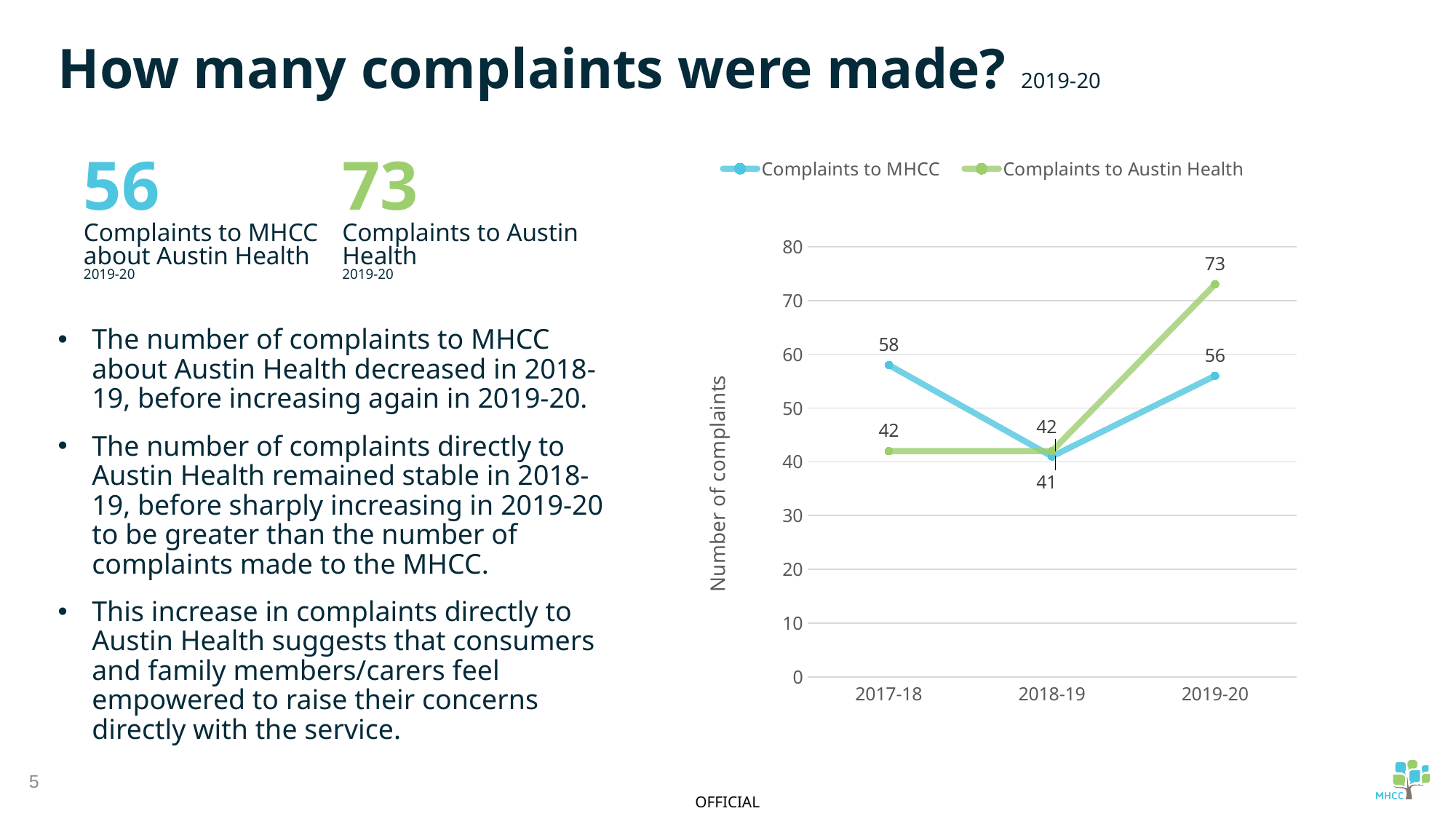
What is the difference between Complaints to Austin Health and Complaints to MHCC in 2019-20? 17 What kind of chart is shown on the slide? line chart What is the label on the y axis? Number of complaints How does Complaints to Austin Health change from 2018-19 to 2019-20? rises Which is larger in 2017-18, Complaints to MHCC or Complaints to Austin Health? Complaints to MHCC How many points are plotted on the x axis? 3 What is the value for Complaints to MHCC in 2018-19? 41 What is the value for Complaints to Austin Health in 2019-20? 73 In which year is Complaints to Austin Health highest? 2019-20 What is the value for Complaints to MHCC in 2017-18? 58 In which year is Complaints to MHCC lowest? 2018-19 How many series does the legend list? 2